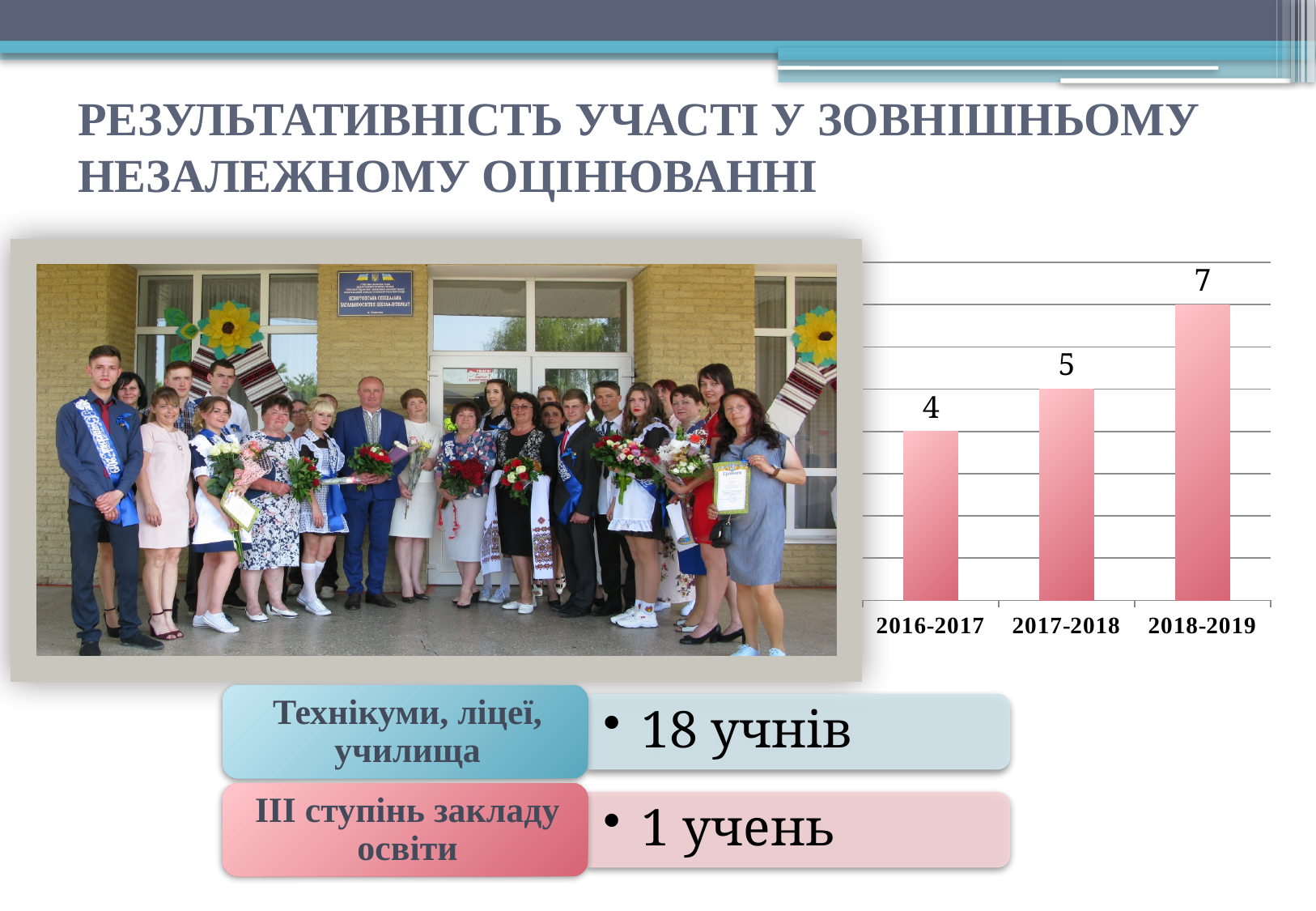
Which is larger, the value for 2017-2018 or the value for 2016-2017? 2017-2018 What kind of chart is shown on the slide? bar chart What is the difference between the values for 2018-2019 and 2016-2017? 3 Which category has the lowest value in the bar chart? 2016-2017 What is the value for 2017-2018 in the bar chart? 5 How many categories are shown on the x axis of the bar chart? 3 Do the values rise or fall from 2016-2017 to 2018-2019? rise What is the value for 2016-2017 in the bar chart? 4 What is the value for 2018-2019 in the bar chart? 7 What colour are the bars in the chart? pink What is the difference between the values for 2018-2019 and 2017-2018? 2 Which category has the highest value in the bar chart? 2018-2019